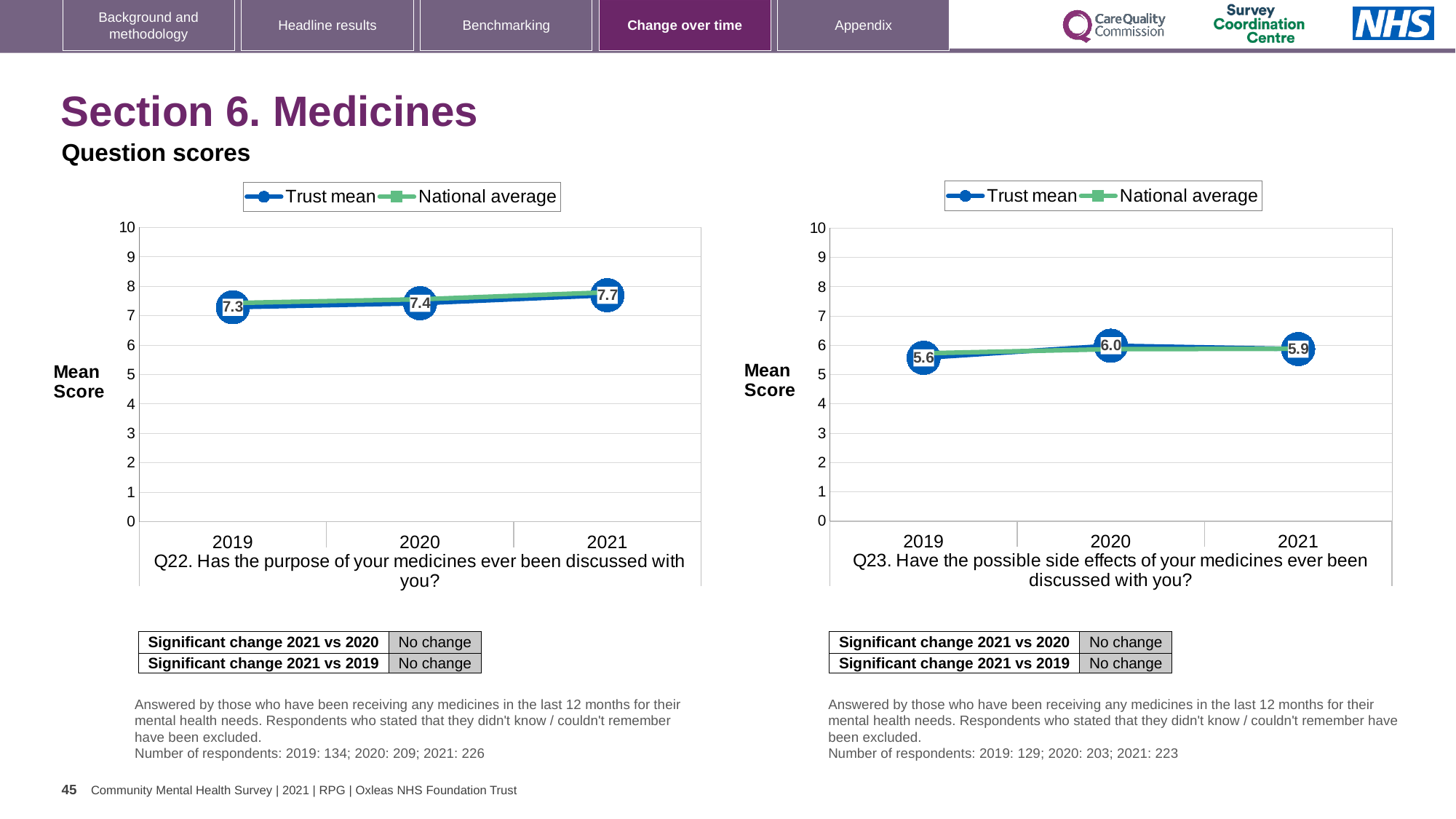
In the Q23 chart (right), which year has the lowest Trust mean? 2019 In the Q22 chart (left), what is the difference between the Trust mean for 2021 and 2019? 0.4 In the Q22 chart (left), does the Trust mean rise or fall from 2019 to 2021? rise What kind of chart is the Q23 chart (right)? line chart In the Q23 chart (right), what is the Trust mean for 2019? 5.6 In the Q22 chart (left), what is the Trust mean for 2019? 7.3 In the Q23 chart (right), what is the Trust mean for 2020? 6.0 How many series does the legend of the Q23 chart (right) list? 2 In the Q22 chart (left), which year has the highest Trust mean? 2021 In the Q23 chart (right), is the Trust mean for 2020 or 2019 larger? 2020 How many years are plotted on the x axis of the Q22 chart (left)? 3 In the Q22 chart (left), what is the Trust mean for 2021? 7.7